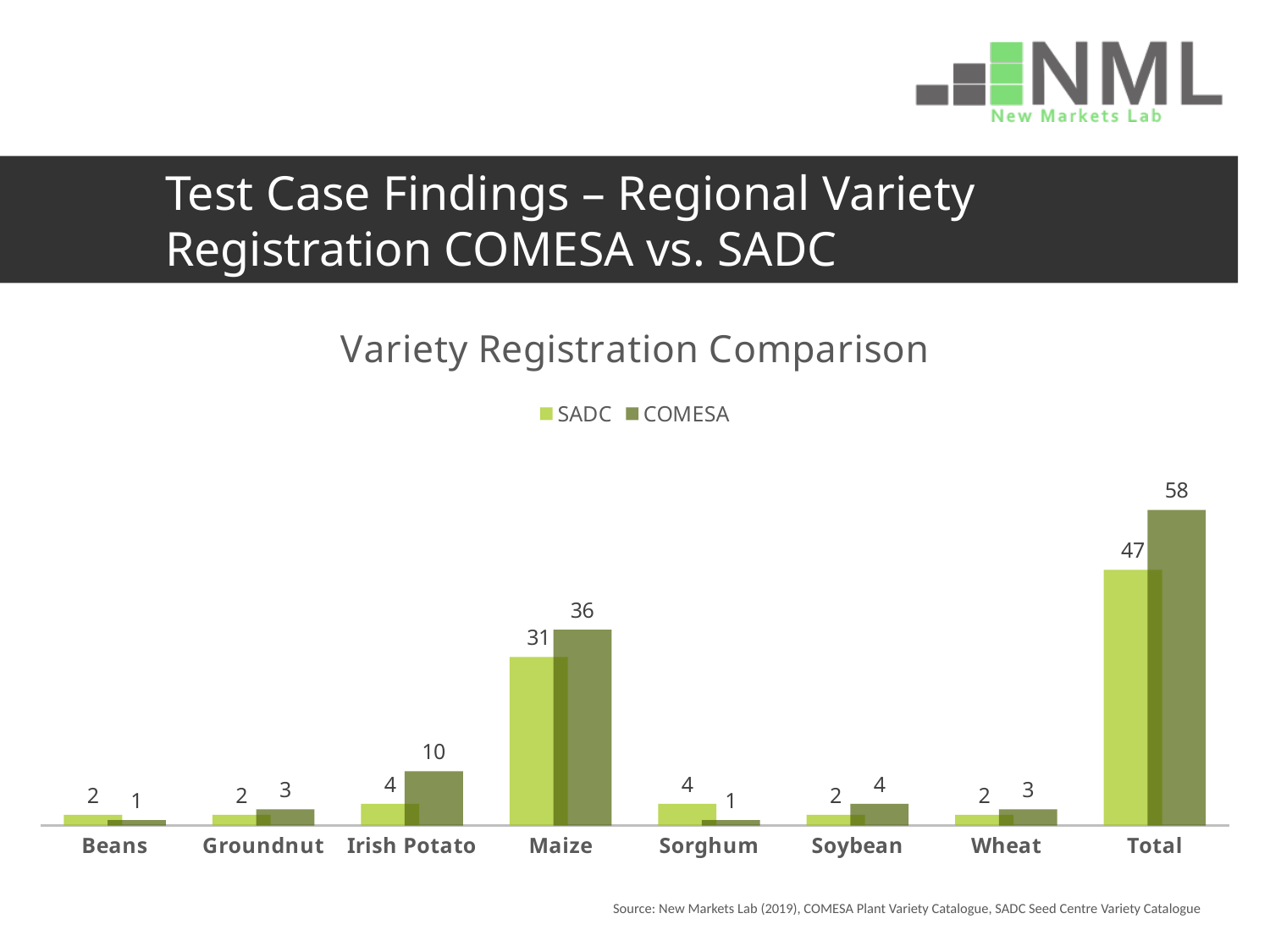
Excluding Total, which crop has the highest COMESA value? Maize What is the COMESA value for Maize? 36 What is the difference between the COMESA and SADC values for Irish Potato? 6 How many series does the legend list? 2 Which is larger for Sorghum, the SADC value or the COMESA value? SADC How many categories are shown on the x axis? 8 What kind of chart is shown? Bar chart What is the SADC value for Irish Potato? 4 What is the difference between the COMESA and SADC values for Total? 11 Which crop has the lowest COMESA value? Beans and Sorghum (both 1) What is the title of the chart? Variety Registration Comparison What is the SADC value for Total? 47